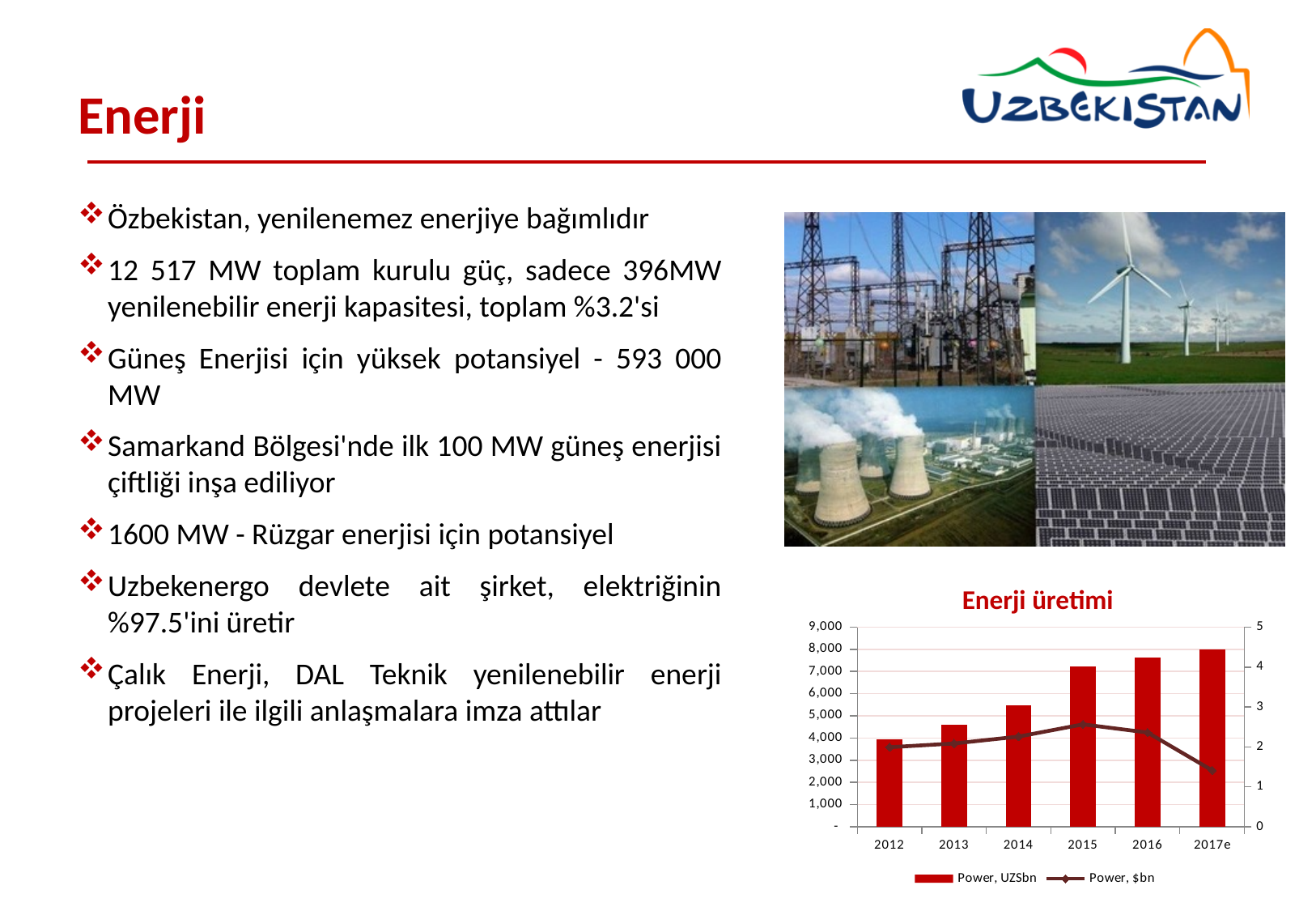
What is the title of the chart on the slide? Enerji üretimi Which is larger, the Power, UZSbn bar for 2014 or for 2016? 2016 How many years are shown on the x axis of the "Enerji üretimi" chart? 6 Is the Power, UZSbn value for 2015 greater or less than 7,000? greater How many series does the legend of the "Enerji üretimi" chart list? 2 What kind of chart is shown under the title "Enerji üretimi"? A combined bar and line chart In which year does the Power, $bn line reach its highest point? 2015 Which year has the shortest bar for Power, UZSbn in the "Enerji üretimi" chart? 2012 In which year does the Power, $bn line reach its lowest point? 2017e Do the Power, UZSbn bars rise or fall from 2012 to 2017e in the "Enerji üretimi" chart? Rise Which year has the tallest bar for Power, UZSbn in the "Enerji üretimi" chart? 2017e